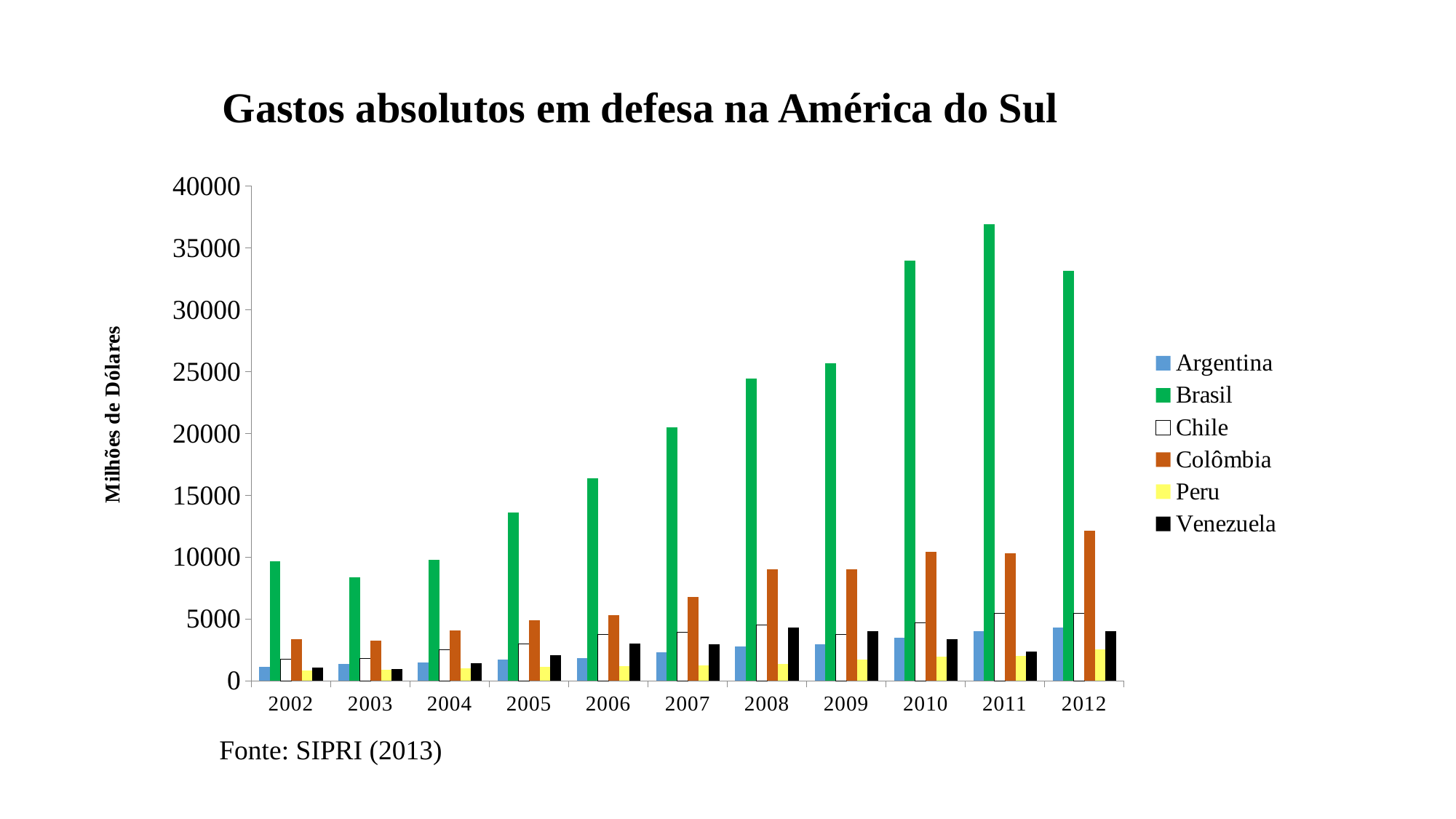
In which year is Brasil's defense spending lowest? 2003 What is the label of the vertical axis? Milhões de Dólares Which is larger in 2012, the value for Colômbia or the value for Venezuela? Colômbia Which country has the highest defense spending in 2012? Brasil Is the value for Colômbia in 2012 greater or less than 10000? greater How many series does the legend list? 6 Is the value for Brasil in 2006 greater or less than 15000? greater Is the value for Argentina in 2012 greater or less than 5000? less In which year is Brasil's defense spending highest? 2011 How many years are shown on the x axis? 11 What kind of chart is shown on the slide? bar chart